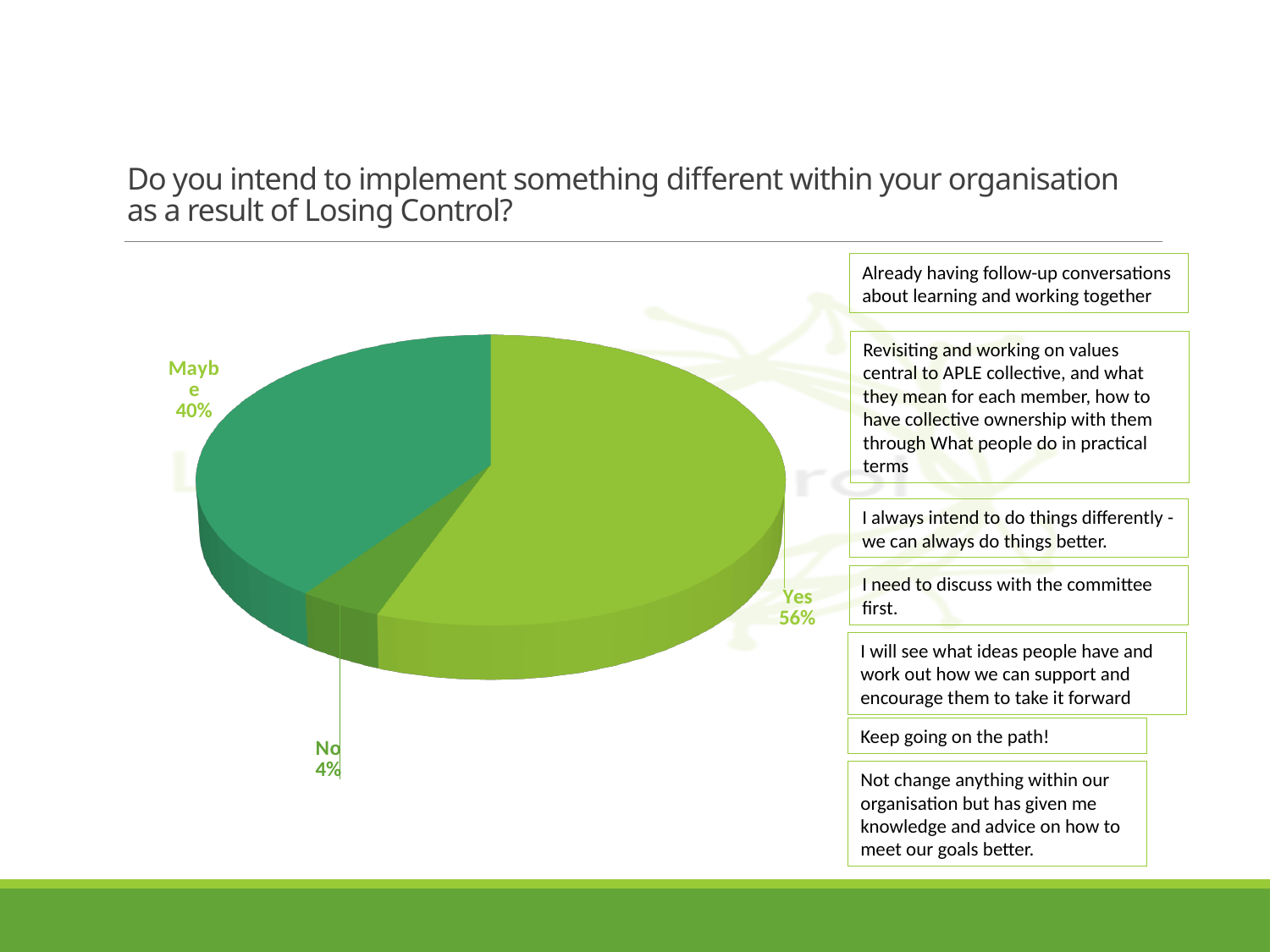
Which slice of the pie is the largest? Yes What share of the pie does the Maybe slice represent? 40% What share of the pie does the No slice represent? 4% What question does the chart title ask? Do you intend to implement something different within your organisation as a result of Losing Control? What kind of chart is shown on the slide? pie chart What is the difference in percentage points between the Yes and Maybe slices? 16 Which slice of the pie is the smallest? No How many slices does the pie chart have? 3 Which is larger, the Yes slice or the Maybe slice? Yes What is the difference in percentage points between the Maybe and No slices? 36 What share of the pie does the Yes slice represent? 56% Is the share for Yes greater or less than 50%? greater